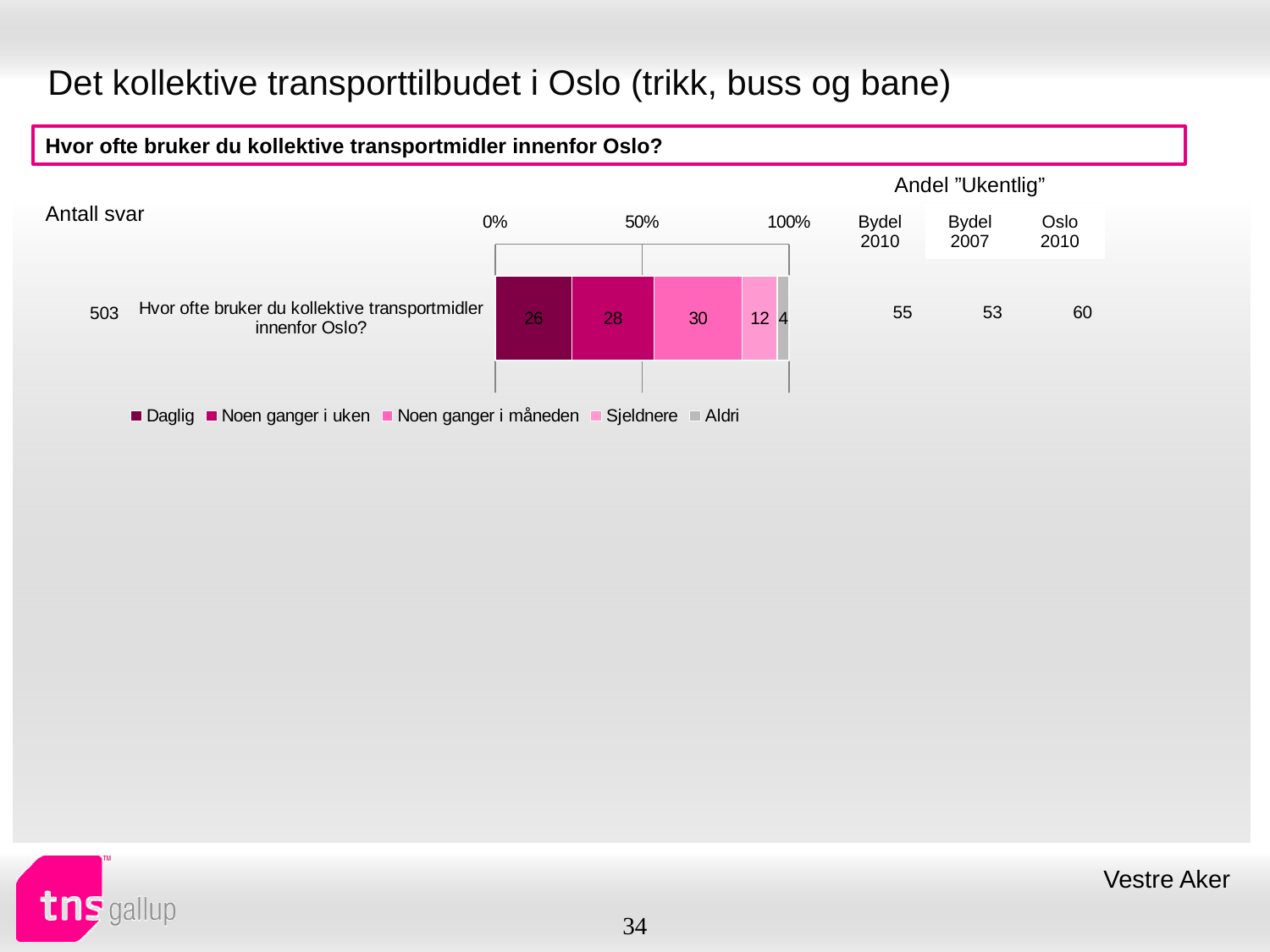
What is the value for "Aldri" in the bar? 4 What is the difference between the "Noen ganger i måneden" and "Daglig" values? 4 Which series has the smallest segment in the bar? Aldri What is the total of all segments in the stacked bar? 100 What is the value for "Noen ganger i uken" in the bar? 28 How many series does the legend list? 5 What kind of chart is shown on the slide? stacked bar chart Which series has the largest segment in the bar? Noen ganger i måneden What is the value for "Noen ganger i måneden" in the bar? 30 What is the value for "Daglig" in the bar? 26 What is the value for "Sjeldnere" in the bar? 12 Which is larger, the value for "Sjeldnere" or the value for "Aldri"? Sjeldnere